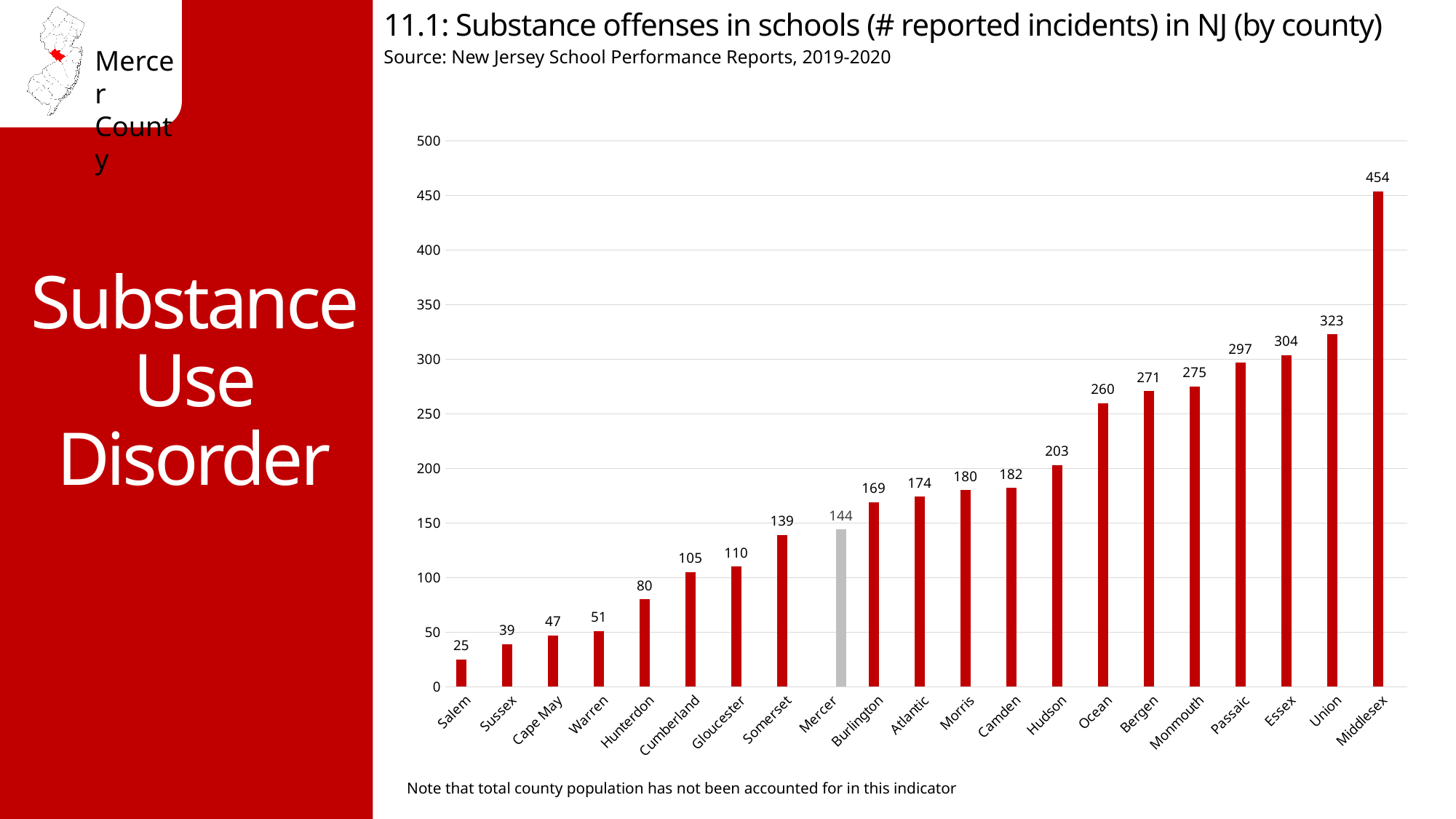
Which county has the lowest number of reported incidents? Salem What is the difference between the values for Middlesex and Union? 131 How many counties are shown on the x axis? 21 Which county has the highest number of reported incidents? Middlesex Is the value for Bergen greater or less than 250? greater What is the number of reported substance offense incidents in schools for Mercer County? 144 Which county's bar is coloured grey instead of red? Mercer How many more incidents does Mercer have than Somerset? 5 Do the values rise or fall moving from left to right along the x axis? Rise What is the value shown for Hudson County? 203 Which county has a larger value, Passaic or Ocean? Passaic What kind of chart is shown on the slide? Bar chart